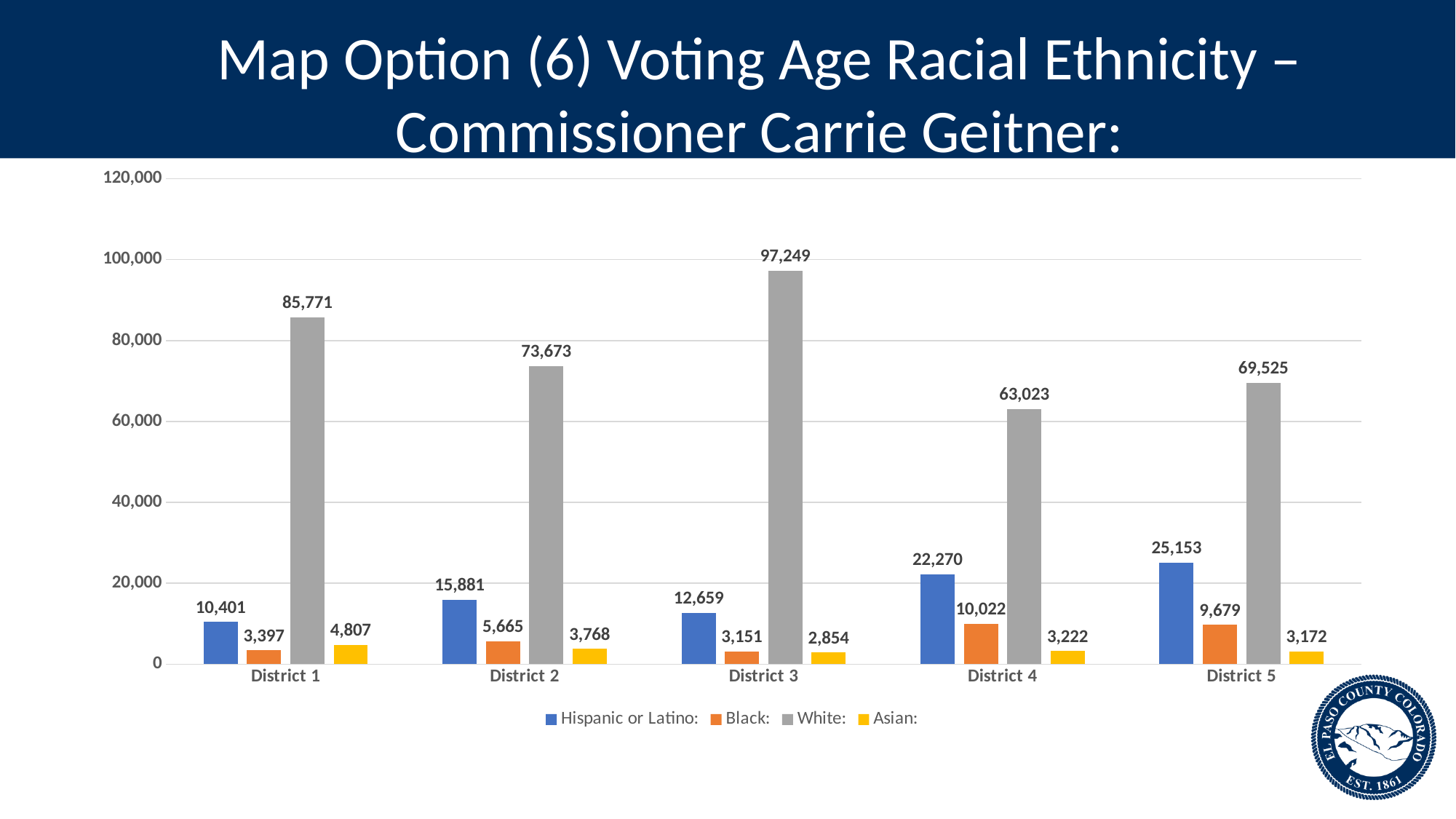
Which colour represents the White series in the legend? Gray What is the Hispanic or Latino value for District 5? 25,153 What is the Asian value for District 1? 4,807 Which district has the highest White value? District 3 What is the difference between the White values for District 1 and District 2? 12,098 What is the Black value for District 4? 10,022 What is the White voting age population in District 3? 97,249 How many series does the legend list? 4 Which is larger, the Hispanic or Latino value for District 4 or for District 2? District 4 What kind of chart is shown on the slide? Bar chart How many districts are shown on the x axis? 5 Which district has the lowest Asian value? District 3